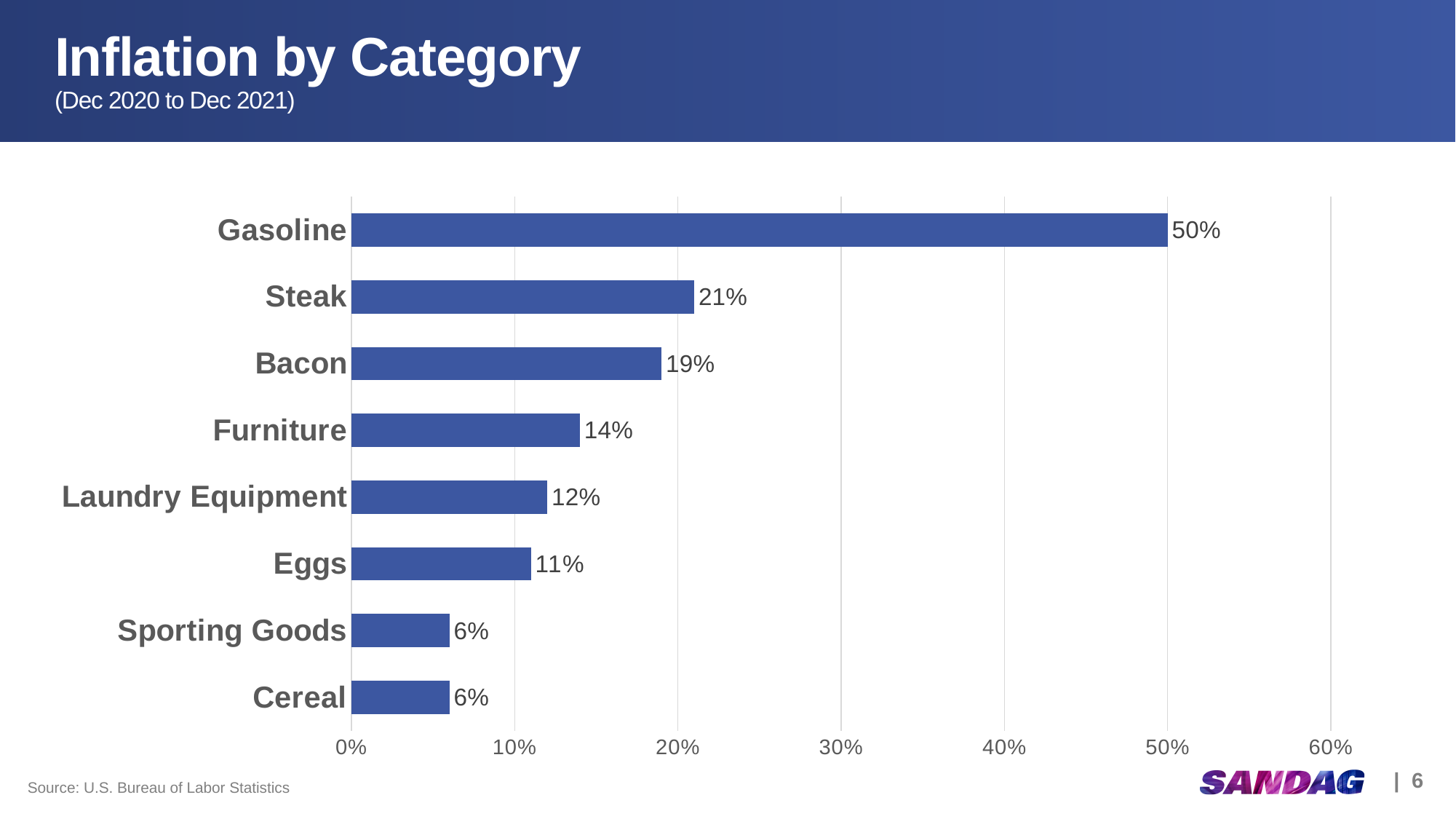
What is the inflation value for Laundry Equipment? 12% What is the title of the chart on the slide? Inflation by Category What is the inflation value for Bacon? 19% What kind of chart is shown on the slide? Bar chart Which category has the highest inflation? Gasoline What is the inflation value for Gasoline? 50% Is the value for Steak greater or less than 20%? greater What is the difference between the inflation values for Steak and Furniture? 7% Which has a higher inflation value, Eggs or Laundry Equipment? Laundry Equipment What is the difference between the inflation values for Gasoline and Eggs? 39% How many categories are shown in the chart? 8 Which has a higher inflation value, Bacon or Furniture? Bacon